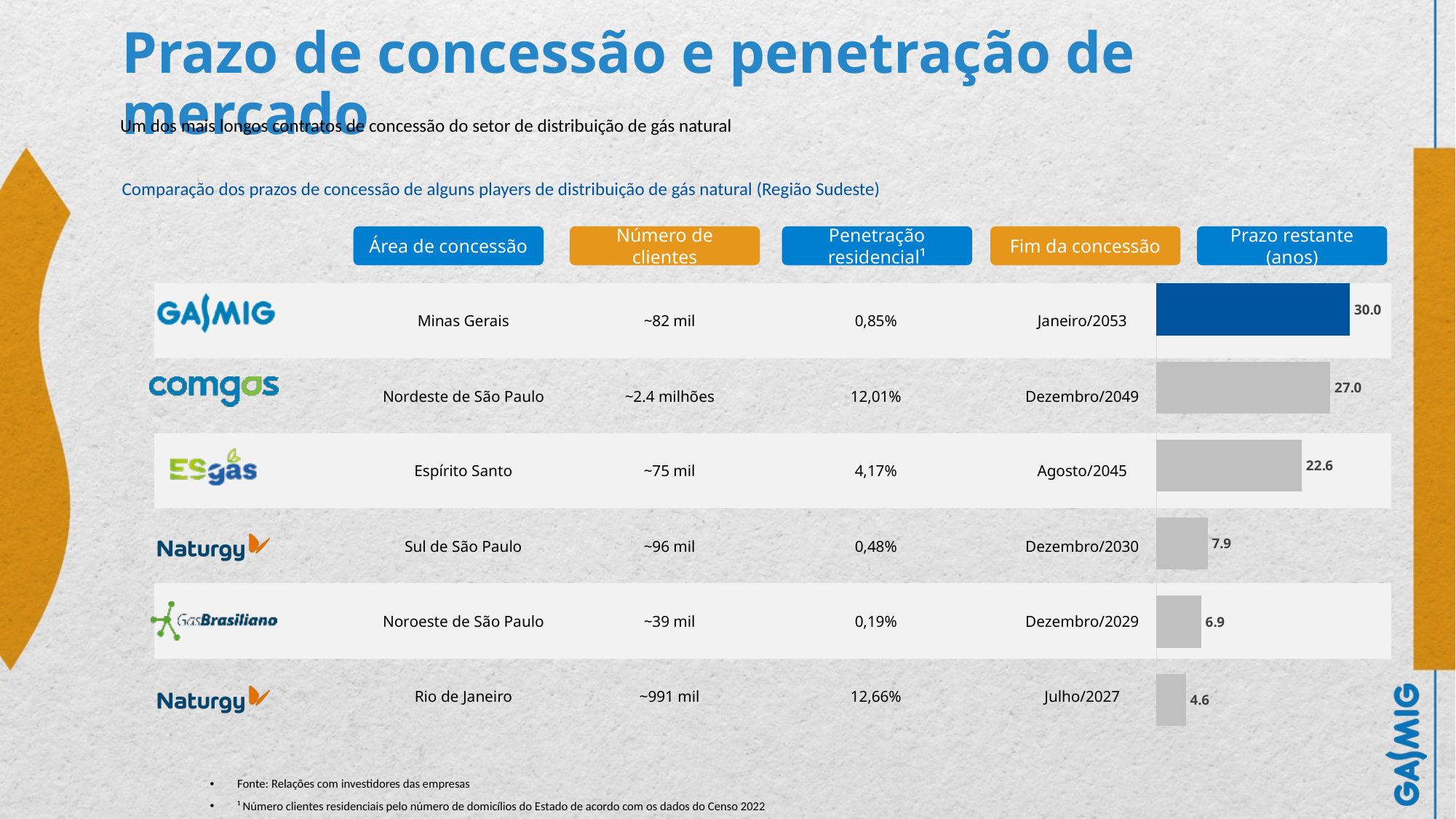
What kind of chart is used for the 'Prazo restante (anos)' column? Bar chart How many bars are shown in the 'Prazo restante (anos)' bar chart? 6 In the 'Prazo restante (anos)' bar chart, which is larger: the value for Espírito Santo or the value for Sul de São Paulo? Espírito Santo In the 'Prazo restante (anos)' bar chart, what is the difference between the values for Minas Gerais and Nordeste de São Paulo? 3.0 In the 'Prazo restante (anos)' bar chart, what is the value for Espírito Santo? 22.6 In the 'Prazo restante (anos)' bar chart, which concession area has the highest value? Minas Gerais In the 'Prazo restante (anos)' bar chart, what is the value for Nordeste de São Paulo? 27.0 In the 'Prazo restante (anos)' bar chart, what is the difference between the values for Sul de São Paulo and Noroeste de São Paulo? 1.0 In the 'Prazo restante (anos)' bar chart, which bar is coloured dark blue rather than grey? Minas Gerais (Gasmig) In the 'Prazo restante (anos)' bar chart, which concession area has the lowest value? Rio de Janeiro In the 'Prazo restante (anos)' bar chart, what is the value for Rio de Janeiro? 4.6 In the 'Prazo restante (anos)' bar chart, what is the value for Minas Gerais? 30.0